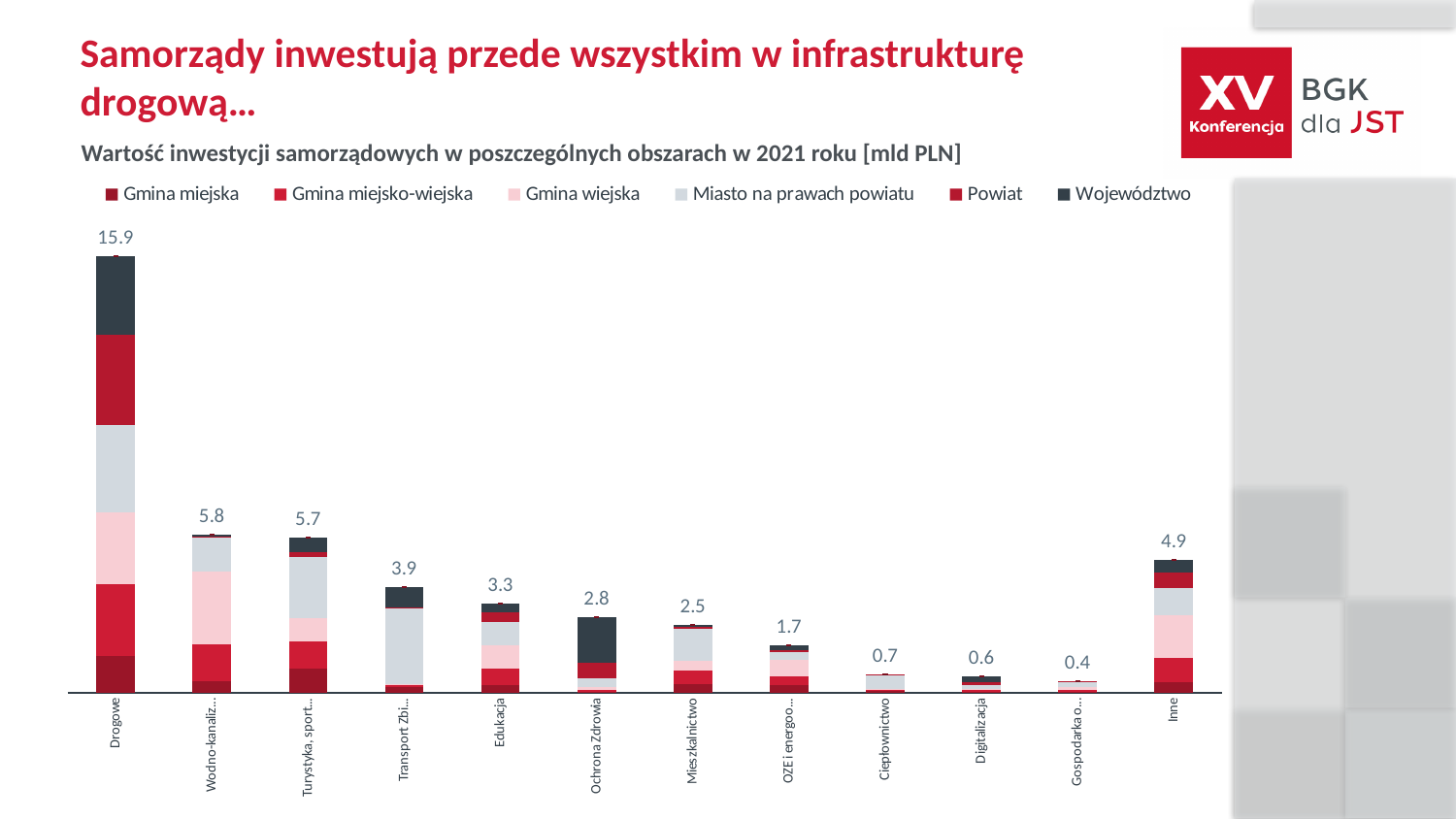
How many categories are shown on the x axis? 12 What is the total value for Inne? 4.9 What is the total value for Drogowe? 15.9 Which category has the highest total value? Drogowe What is the total value for Ochrona Zdrowia? 2.8 Which category has the lowest total value? Gospodarka o... What is the difference between the totals for Drogowe and Inne? 11.0 How many series does the legend list? 6 What is the difference between the totals for Digitalizacja and Ciepłownictwo? 0.1 Which has a larger total, Mieszkalnictwo or Ciepłownictwo? Mieszkalnictwo What kind of chart is shown on the slide? Stacked bar chart What is the total value for Edukacja? 3.3